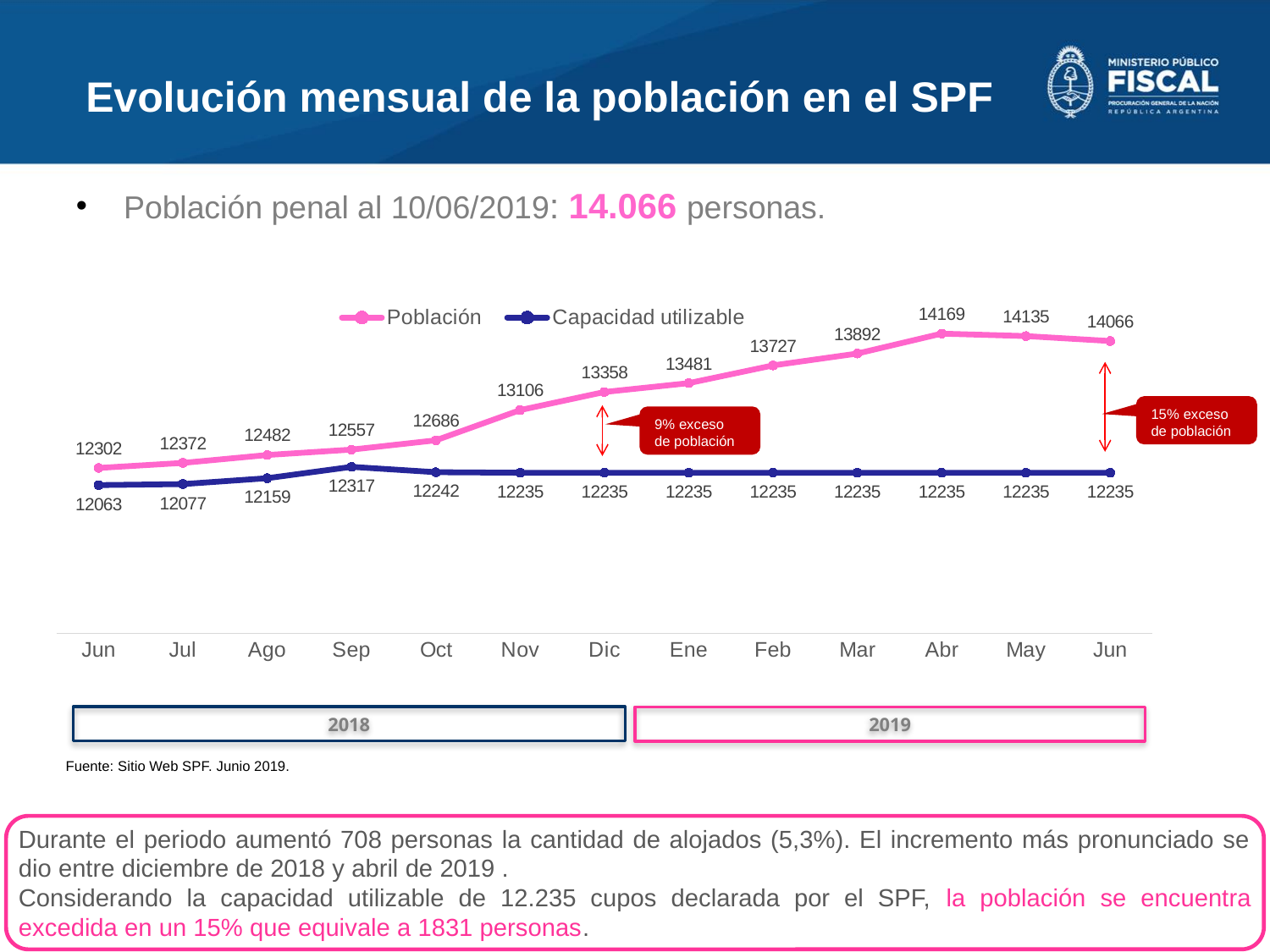
What is the value of Población for Abr (2019)? 14169 In which month is the Capacidad utilizable series at its lowest value? Jun (2018) What is the value of Población for Dic (2018)? 13358 In which month does the Población series reach its highest value? Abr (2019) In which month does the Capacidad utilizable series reach its highest value? Sep (2018) Which is larger, Población in Nov (2018) or Población in Dic (2018)? Dic (2018) What is the difference between Población in Abr (2019) and Población in Mar (2019)? 277 How many series does the legend list? 2 What is the value of Capacidad utilizable for Sep (2018)? 12317 What is the difference between Población and Capacidad utilizable in Jun (2019)? 1831 How many months are plotted on the x axis? 13 What kind of chart is shown on the slide? Line chart